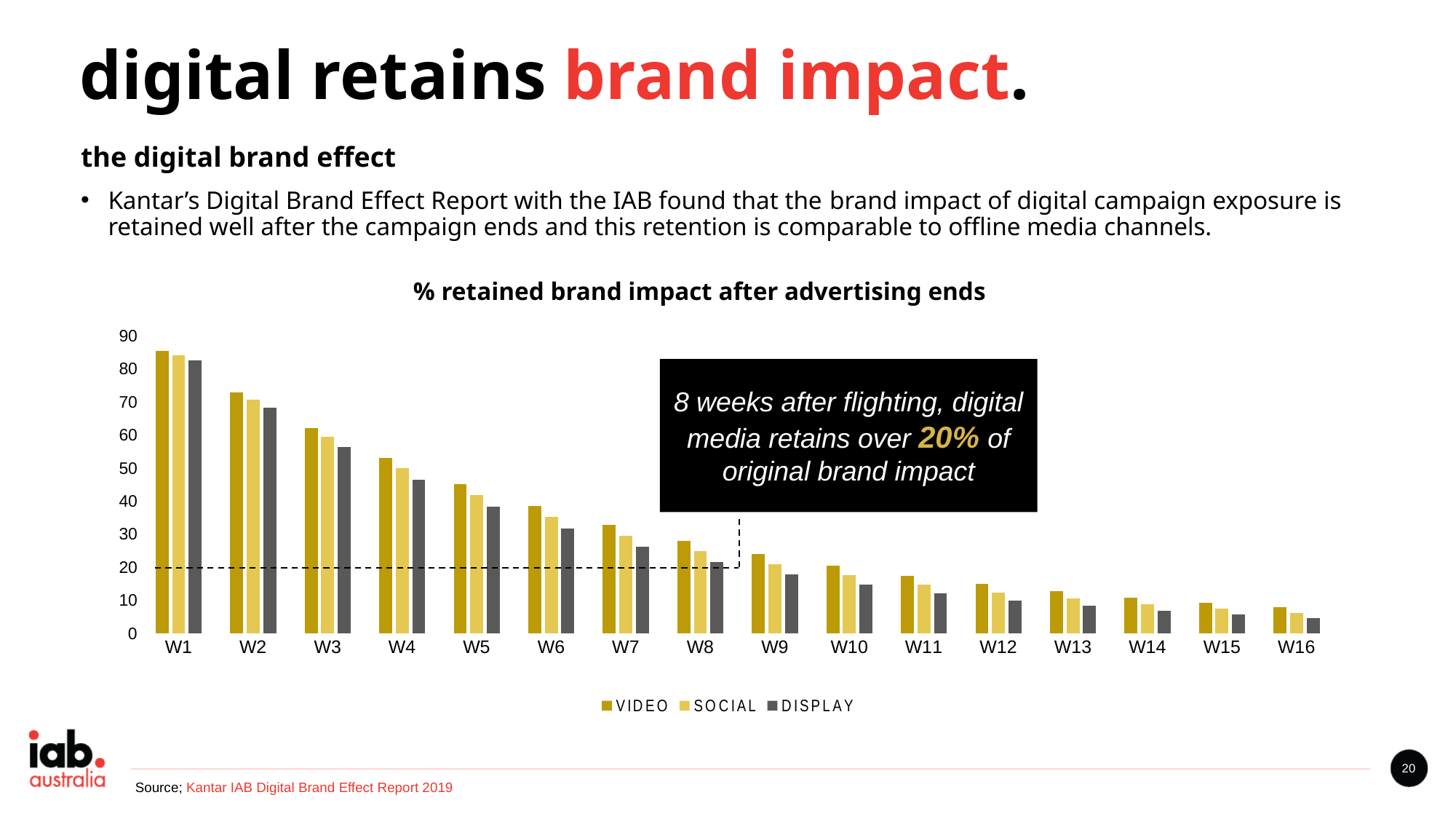
Is the VIDEO value for W16 greater or less than 10? less How many series does the chart legend list? 3 Which is larger: the VIDEO value for W6 or the VIDEO value for W7? W6 How many weeks (categories) are shown on the x axis of the chart? 16 What is the title of the chart? % retained brand impact after advertising ends Do the values in the chart rise or fall from W1 to W16? fall What kind of chart is shown on the slide? bar chart Is the VIDEO value for W1 greater or less than 80? greater Which week has the highest VIDEO value? W1 Which week has the lowest DISPLAY value? W16 Which is larger in W3: the VIDEO value or the DISPLAY value? VIDEO Is the DISPLAY value for W4 greater or less than 50? less